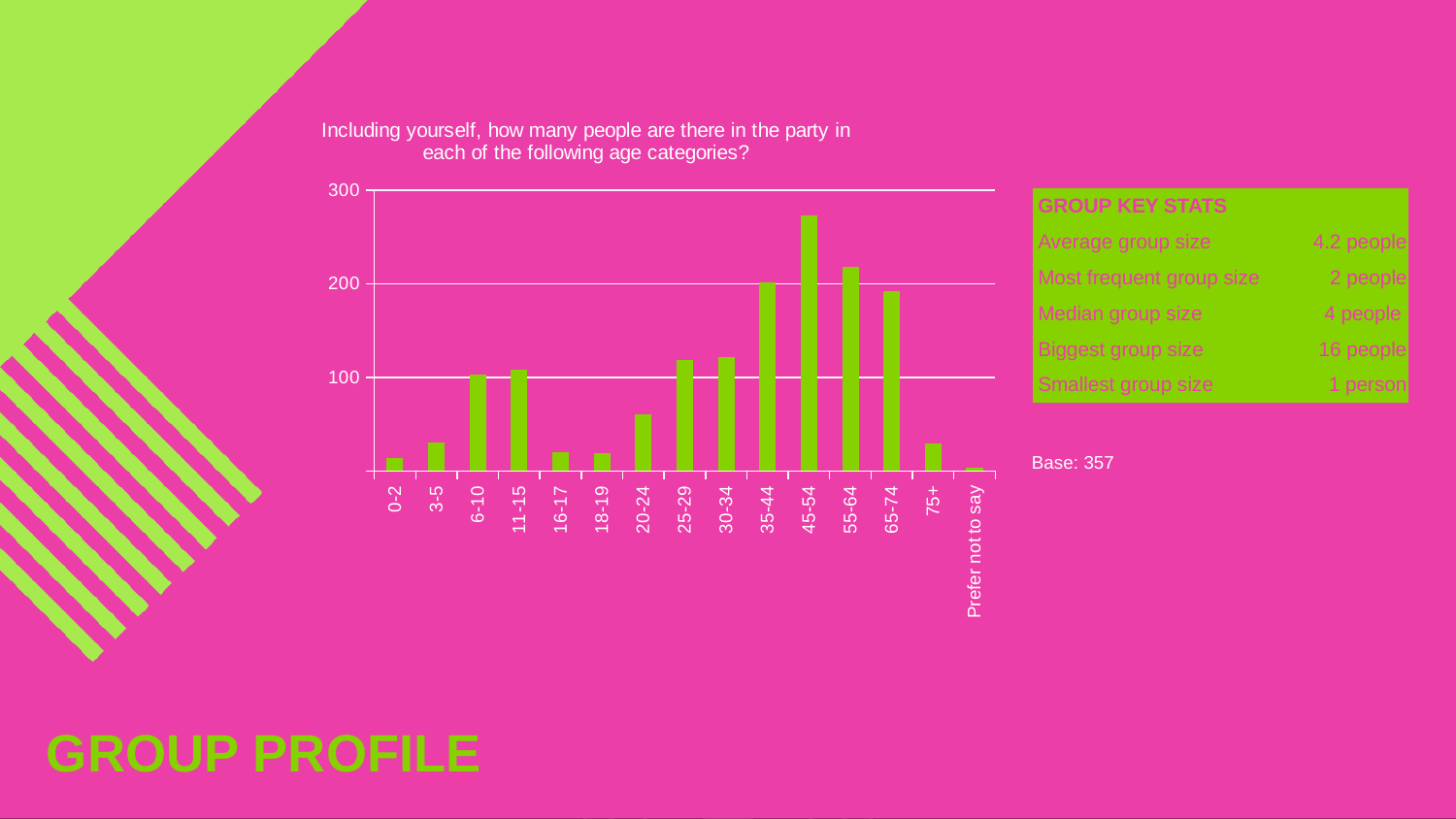
How many age categories are shown on the x axis of the chart? 15 Is the value for 45-54 greater or less than 200? greater Which category has the lowest bar in the chart? Prefer not to say Is the value for 30-34 greater or less than 100? greater Which age category has the highest bar in the chart? 45-54 Is the value for 20-24 greater or less than 100? less Which is larger, the value for 45-54 or the value for 55-64? 45-54 What kind of chart is shown on the slide? bar chart What is the title of the chart? Including yourself, how many people are there in the party in each of the following age categories? Which is larger, the value for 35-44 or the value for 20-24? 35-44